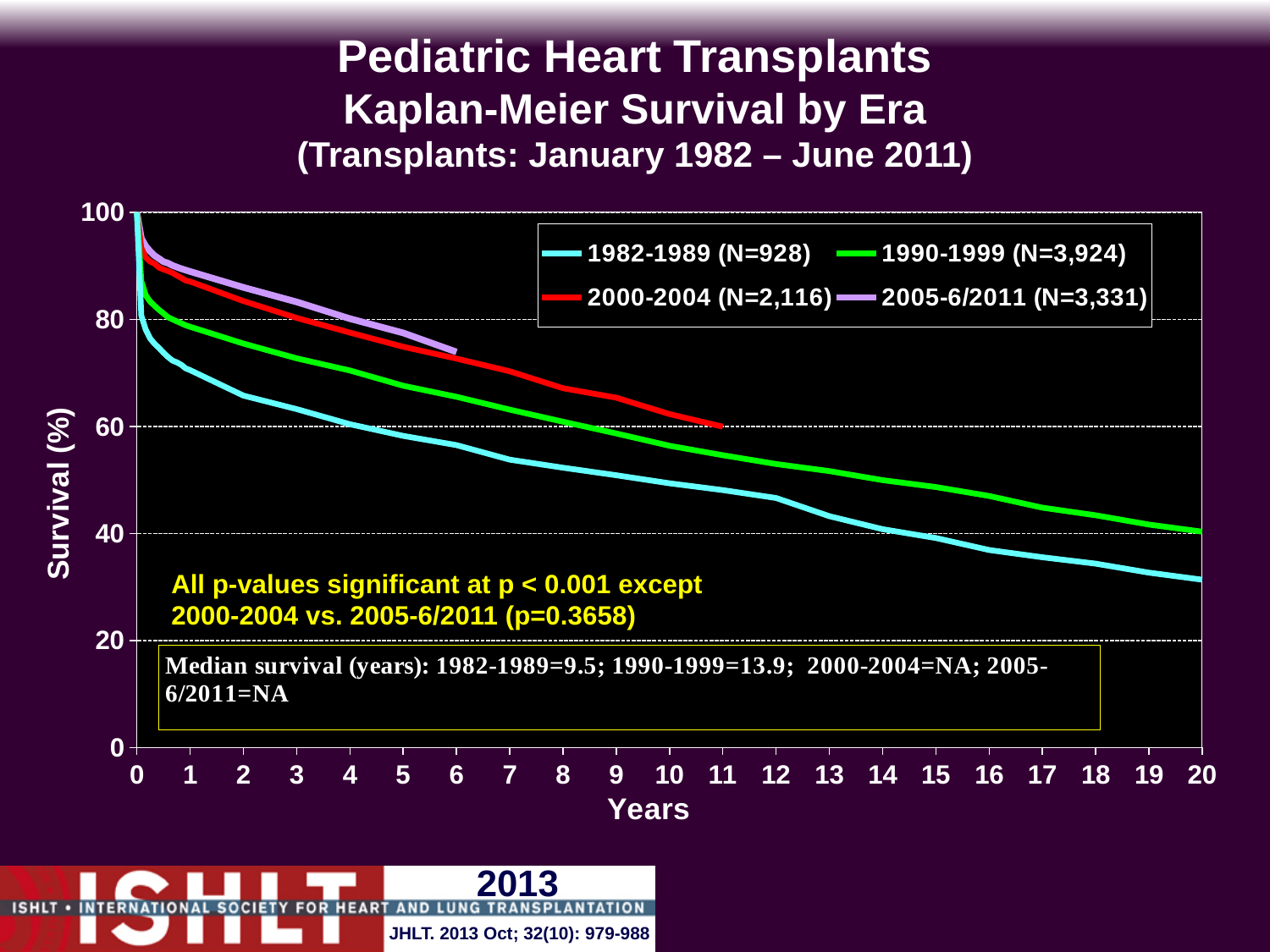
What is the median survival in years for the 1982-1989 era? 9.5 At 10 years, which era has the highest survival? 2000-2004 Is the survival value for the 1982-1989 era at 20 years greater or less than 40? less Is the survival value for the 2005-6/2011 era at 1 year greater or less than 80? greater What is the N shown in the legend for the 1990-1999 era? N=3,924 Is the survival value for the 1990-1999 era at 10 years greater or less than 60? less Do the survival curves rise or fall as years increase? fall What kind of chart is shown on the slide? line chart How many series does the legend list? 4 At 10 years, which era has the lowest survival? 1982-1989 At 5 years, which era has higher survival: 1990-1999 or 1982-1989? 1990-1999